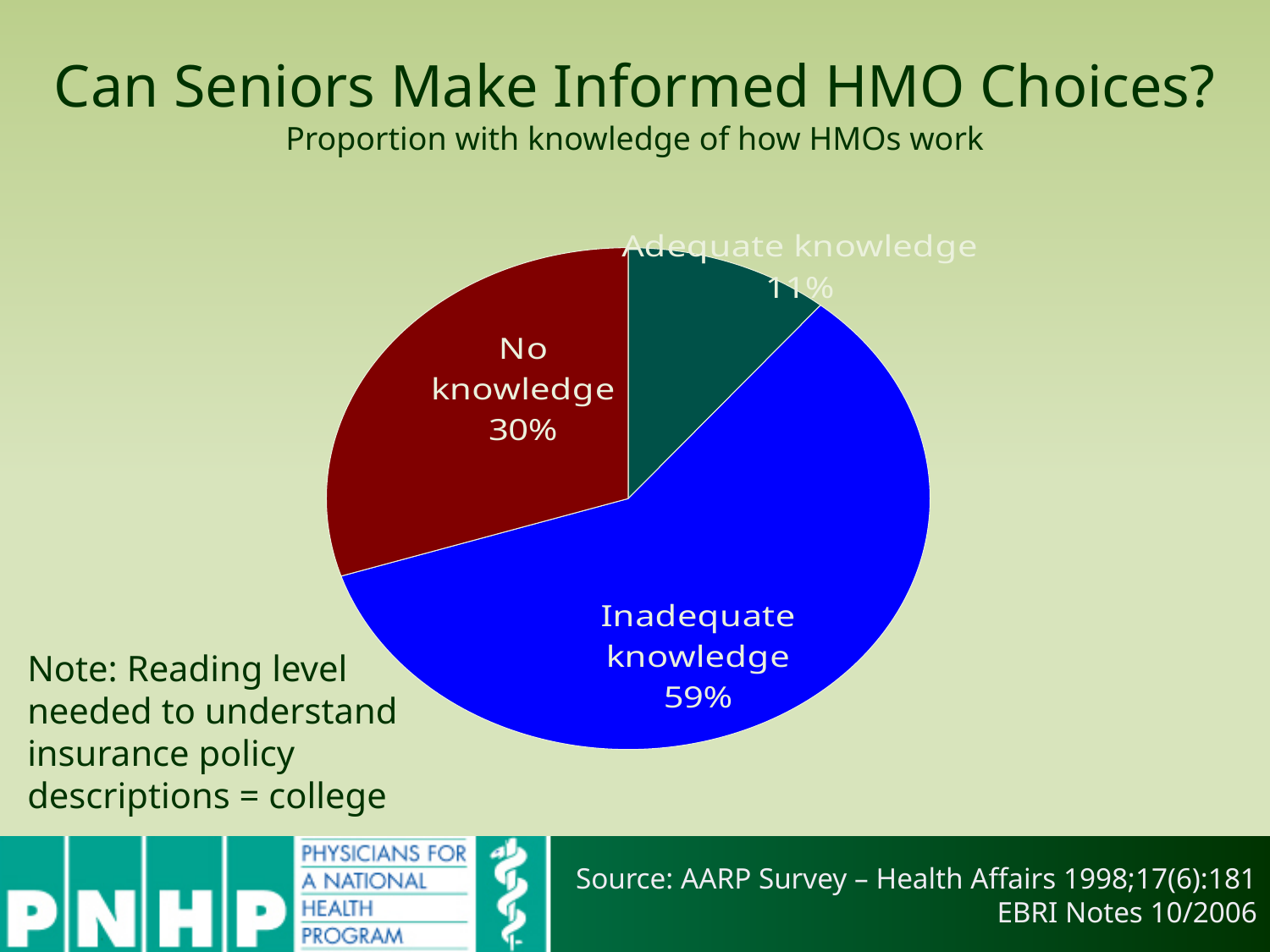
What colour is the Inadequate knowledge slice? Blue Which category has the largest share of the pie? Inadequate knowledge What percentage of seniors have no knowledge of how HMOs work? 30% What kind of chart is shown on the slide? Pie chart Which category has the smallest share of the pie? Adequate knowledge What percentage of seniors have inadequate knowledge of how HMOs work? 59% Which is larger, the share for No knowledge or the share for Adequate knowledge? No knowledge What is the difference in percentage points between No knowledge and Adequate knowledge? 19 What is the difference in percentage points between Inadequate knowledge and No knowledge? 29 What percentage of seniors have adequate knowledge of how HMOs work? 11% What is the subtitle of the chart? Proportion with knowledge of how HMOs work How many slices does the pie chart have? 3